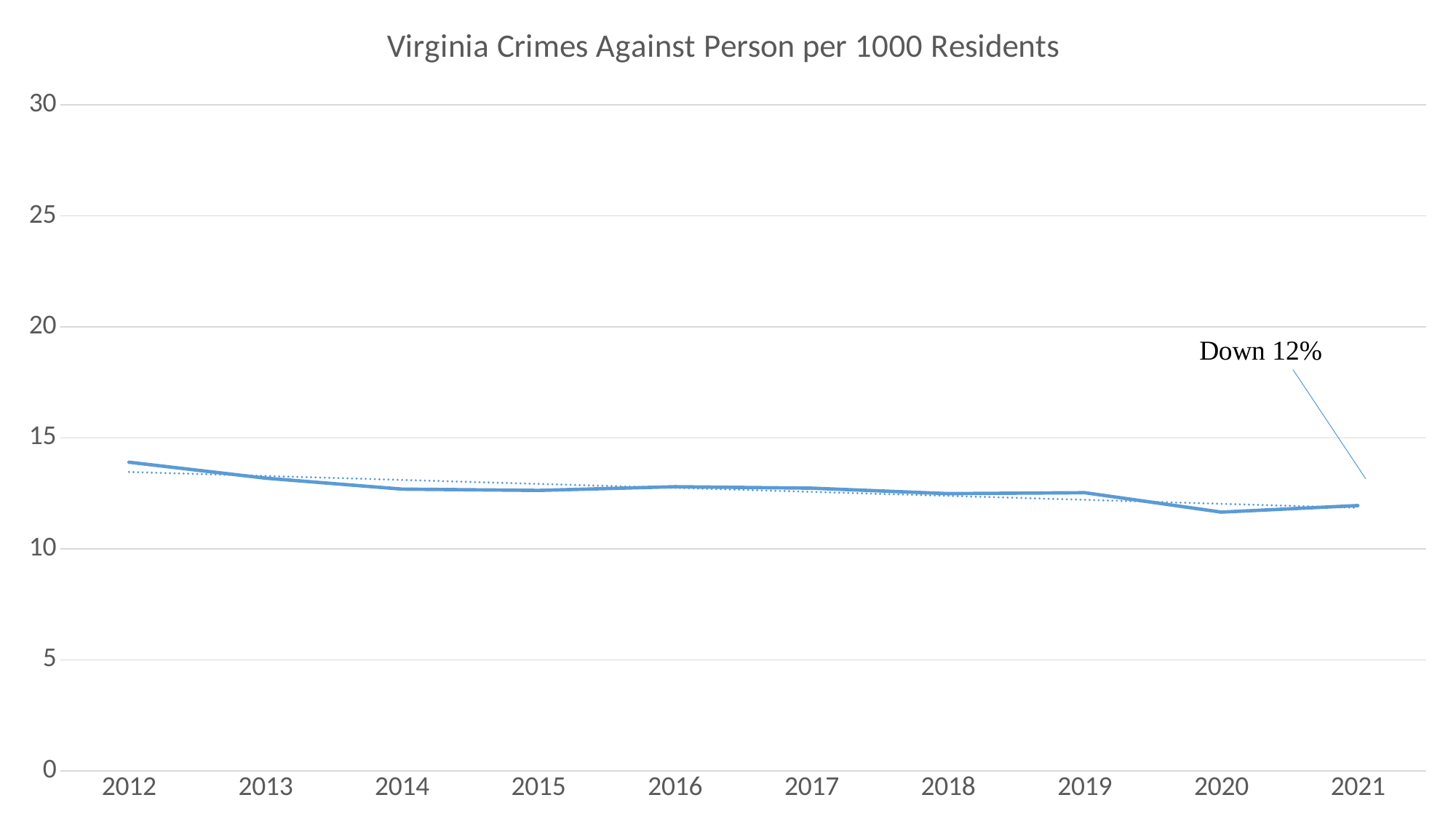
Is the value for 2012 greater or less than 15? less Is the value for 2012 greater or less than 10? greater What is the title of the chart? Virginia Crimes Against Person per 1000 Residents Do the values generally rise or fall from 2012 to 2021? fall What kind of chart is shown on the slide? line chart How many years are plotted along the x axis? 10 What does the annotation near the end of the line say? Down 12% Is the value for 2021 greater or less than 15? less Which year has the lowest value on the chart? 2020 Which year has the highest value on the chart? 2012 Which year has the larger value, 2012 or 2021? 2012